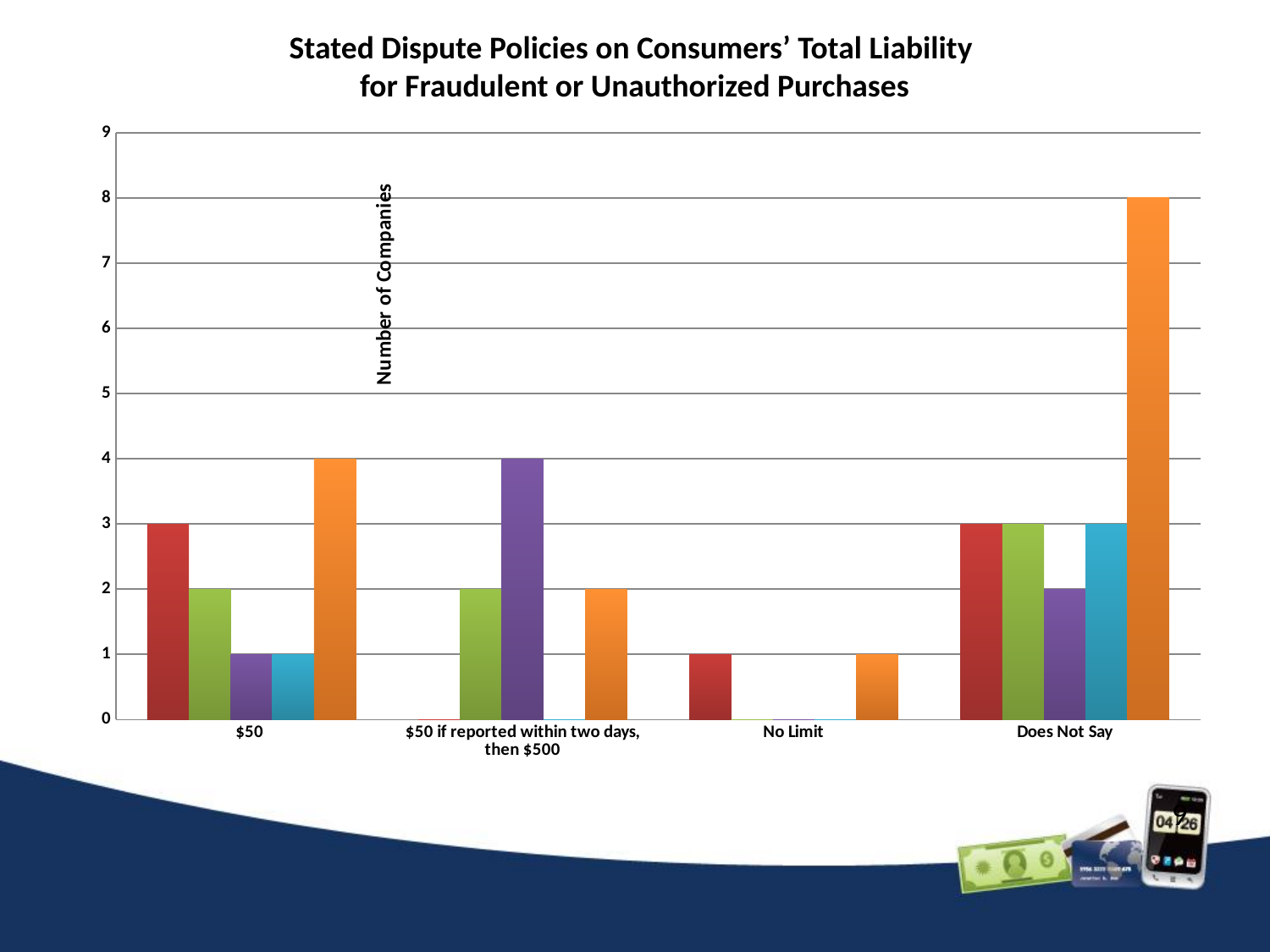
What is the value of the orange bar for the 'No Limit' category? 1 Is the value of the orange bar for 'Does Not Say' greater or less than 5? greater What is the value of the red bar for the '$50' category? 3 What is the value of the blue bar for the 'Does Not Say' category? 3 What kind of chart is shown on the slide? bar chart What is the difference between the orange bar for 'Does Not Say' and the orange bar for '$50'? 4 What is the label of the vertical axis? Number of Companies What is the value of the purple bar for the '$50 if reported within two days, then $500' category? 4 Which is larger: the green bar for '$50' or the green bar for 'Does Not Say'? Does Not Say How many categories are shown along the x axis? 4 For which category is the orange bar highest? Does Not Say What is the value of the orange bar for the 'Does Not Say' category? 8